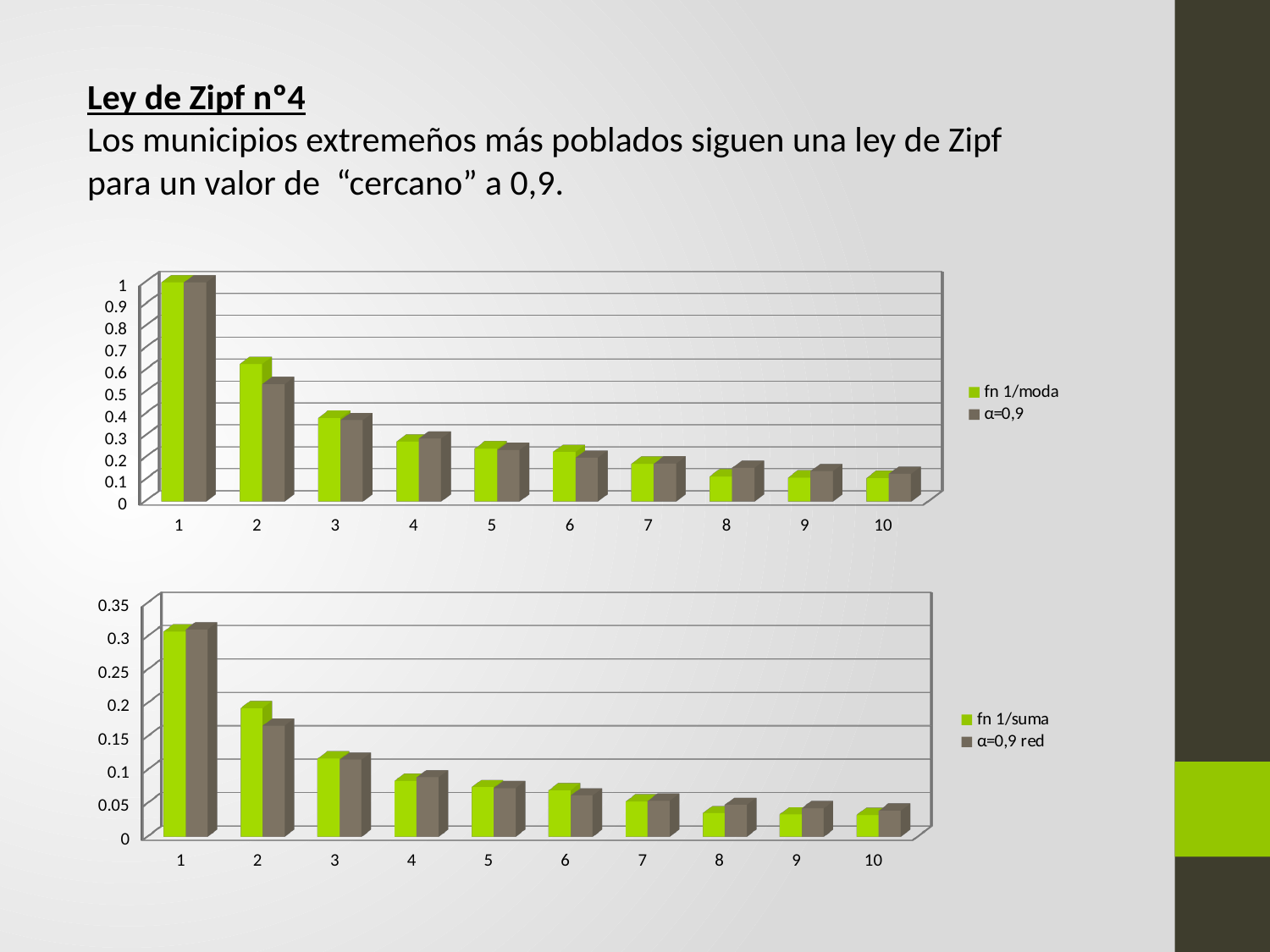
In the top chart, is the value of fn 1/moda for category 8 greater or less than 0.2? less In the top chart, for category 8, which series has the larger value: fn 1/moda or α=0,9? α=0,9 In the bottom chart, do the values of fn 1/suma rise or fall from category 1 to category 10? fall In the top chart, which category has the highest value for fn 1/moda? 1 In the top chart, for category 2, which series has the larger value: fn 1/moda or α=0,9? fn 1/moda In the top chart, what is the value of fn 1/moda for category 1? 1 In the top chart, is the value of fn 1/moda for category 2 greater or less than 0.5? greater In the bottom chart, is the value of fn 1/suma for category 2 greater or less than 0.15? greater What are the two series listed in the legend of the bottom chart? fn 1/suma and α=0,9 red How many categories are shown on the x axis of the bottom chart? 10